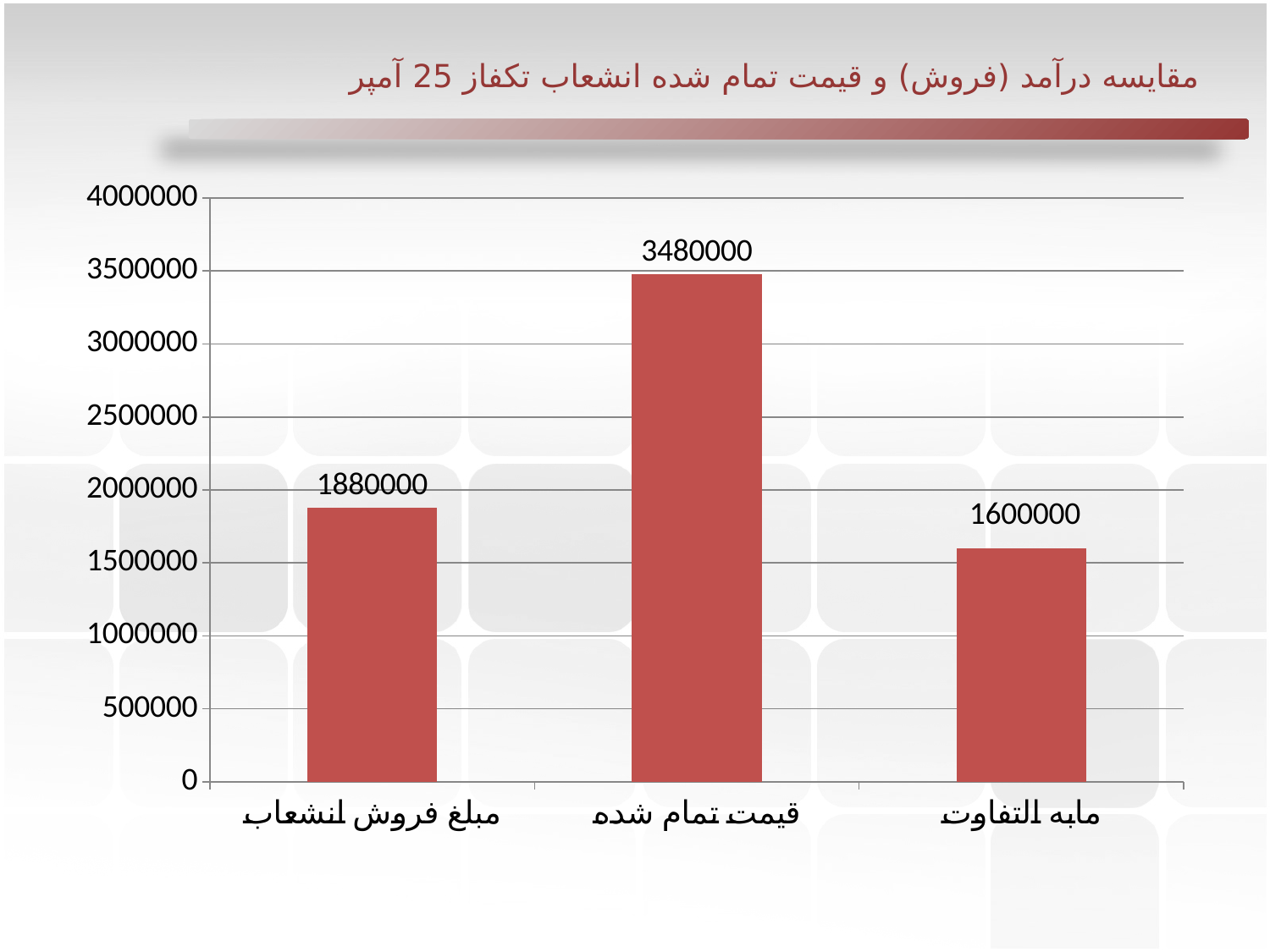
Which category has the highest value? قیمت تمام شده How many categories are shown on the x axis? 3 Which category has the lowest value? مابه التفاوت What is the difference between the values for مبلغ فروش انشعاب and مابه التفاوت? 280000 What kind of chart is shown on the slide? bar chart What is the value for مبلغ فروش انشعاب? 1880000 What is the value for قیمت تمام شده? 3480000 What is the difference between the values for قیمت تمام شده and مبلغ فروش انشعاب? 1600000 What is the value for مابه التفاوت? 1600000 Is the value for قیمت تمام شده greater or less than 3000000? greater Which is larger, the value for مبلغ فروش انشعاب or the value for مابه التفاوت? مبلغ فروش انشعاب What is the title of the slide? مقایسه درآمد (فروش) و قیمت تمام شده انشعاب تکفاز 25 آمپر